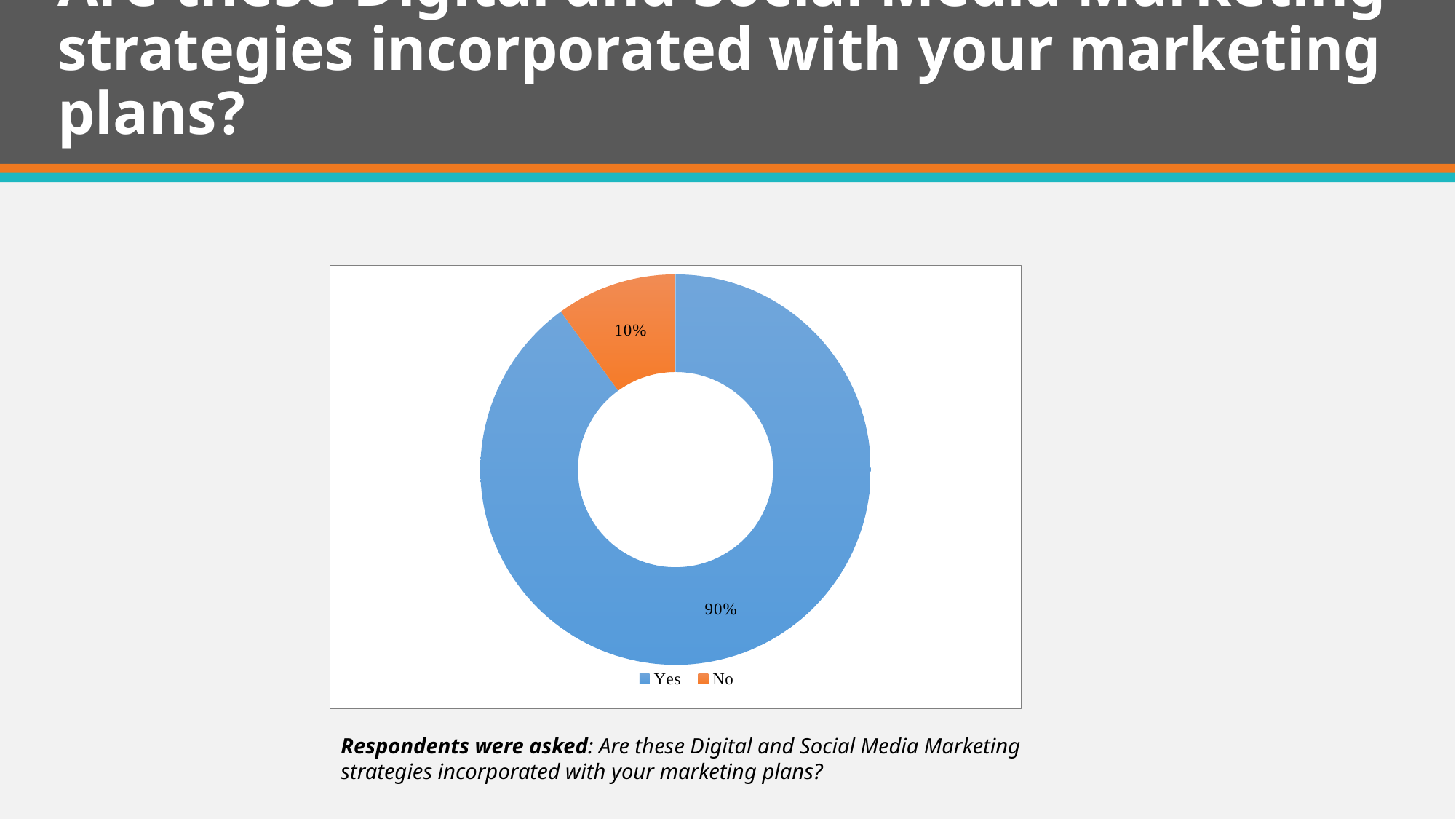
How many categories are shown in the chart? 2 What kind of chart is shown on the slide? Doughnut (pie) chart How many entries does the legend list? 2 Which is larger, the share for Yes or the share for No? Yes What percentage of respondents answered No? 10% What colour is the Yes slice in the chart? Blue Which response has the largest share of the chart? Yes What is the difference in percentage points between the Yes and No shares? 80 What colour is the No slice in the chart? Orange Which response has the smallest share of the chart? No What share of the chart does the Yes slice represent? 90% What percentage of respondents answered Yes? 90%